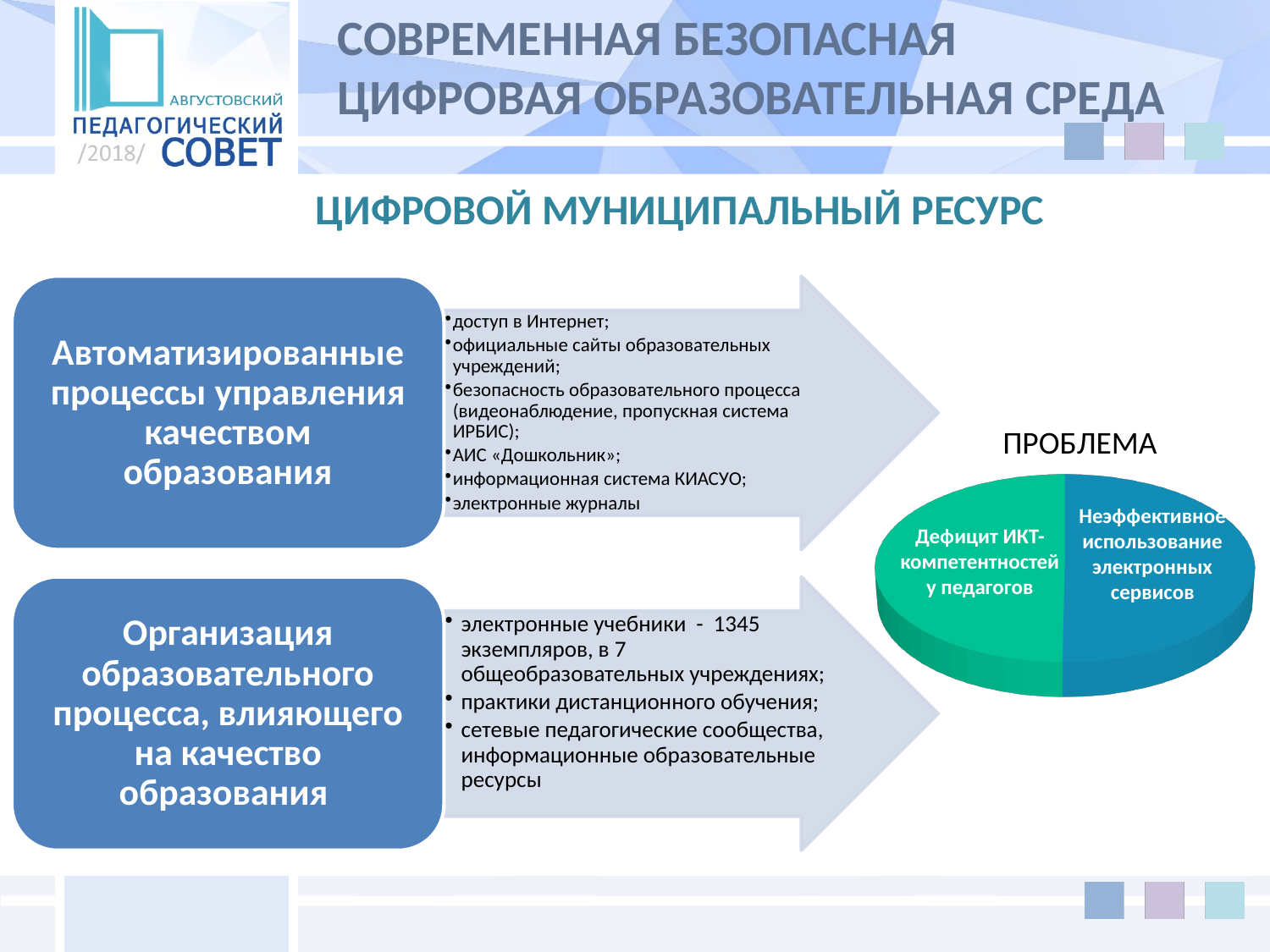
What kind of chart is shown under the heading "ПРОБЛЕМА"? pie chart How many slices does the pie chart on the slide have? 2 What is the label of the green slice of the pie chart? Дефицит ИКТ-компетентностей у педагогов Does the pie chart display any numeric data labels on its slices? No What is the title shown above the pie chart? ПРОБЛЕМА Which slice of the pie chart is coloured blue? Неэффективное использование электронных сервисов